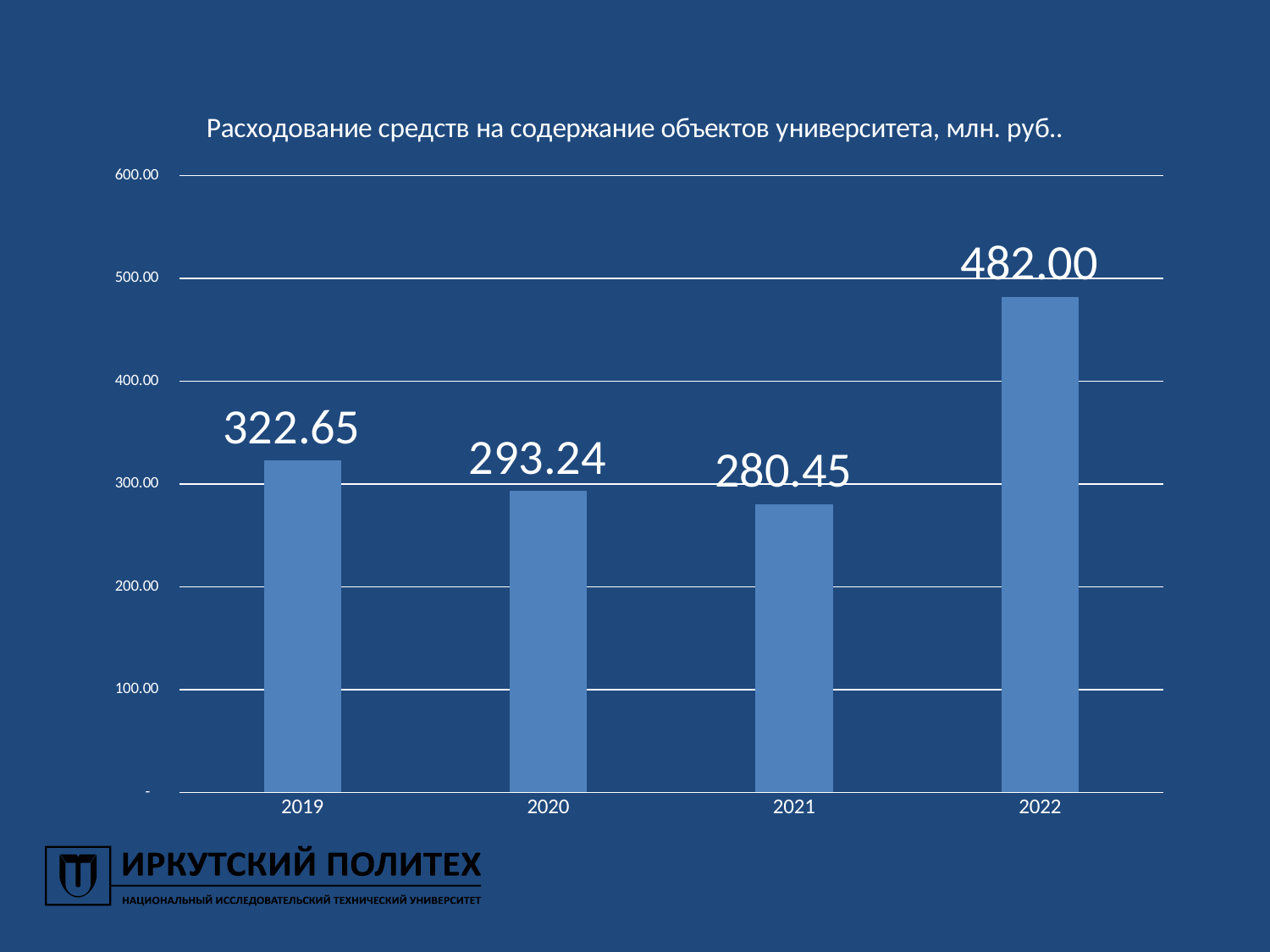
What kind of chart is this? bar chart What is the value for 2021? 280.45 How many years are shown on the x axis? 4 Is the value for 2022 greater or less than 400.00? greater Which is larger, the value for 2019 or the value for 2020? 2019 What is the value for 2022? 482.00 What is the difference between the values for 2022 and 2021? 201.55 What is the value for 2019? 322.65 What is the value for 2020? 293.24 Which year has the highest value? 2022 Which year has the lowest value? 2021 What is the title of the chart? Расходование средств на содержание объектов университета, млн. руб..